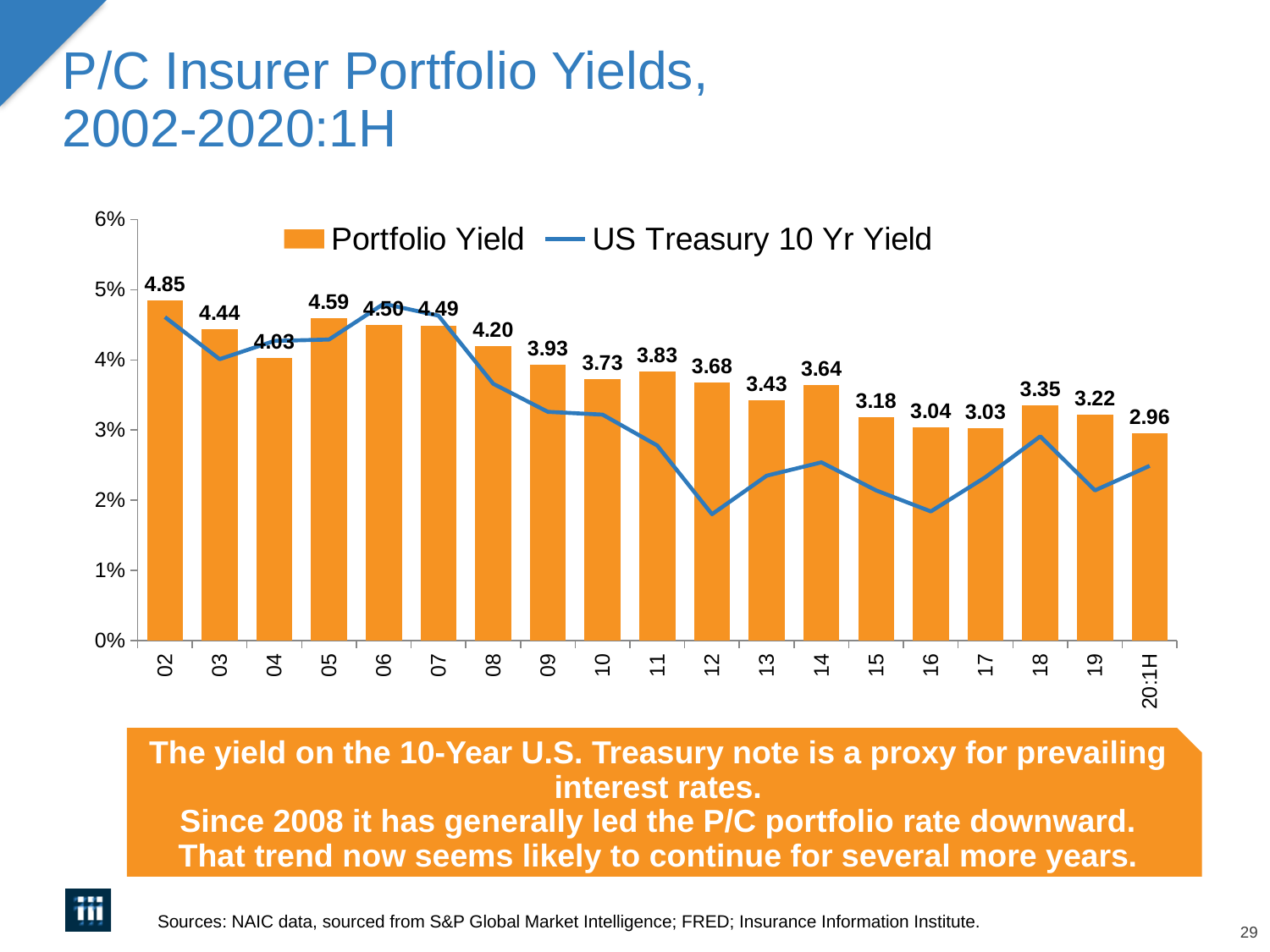
Is the US Treasury 10 Yr Yield for 12 greater or less than 2%? less What is the Portfolio Yield for 20:1H? 2.96 Which period has the lowest Portfolio Yield? 20:1H Is the US Treasury 10 Yr Yield for 02 greater or less than 4%? greater Which has the larger Portfolio Yield, 10 or 11? 11 What is the difference between the Portfolio Yield for 02 and for 20:1H? 1.89 What is the Portfolio Yield for 02? 4.85 What is the Portfolio Yield for 14? 3.64 Do the Portfolio Yield values generally rise or fall from 02 to 20:1H? fall How many periods are shown on the x axis? 19 Which year has the highest Portfolio Yield? 02 How many series does the legend list? 2